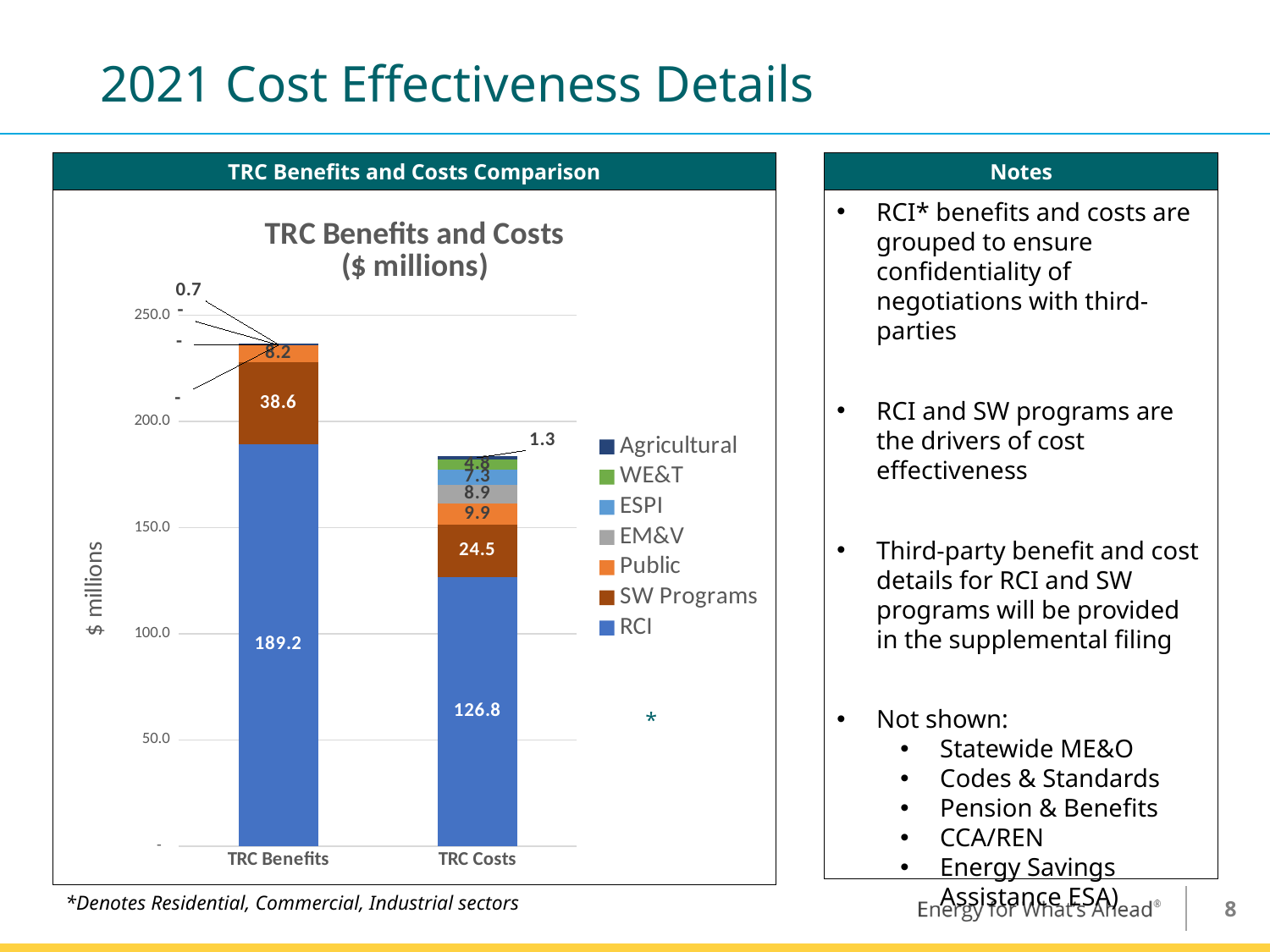
What is the RCI value for TRC Costs? 126.8 How many categories are shown on the x axis? 2 What is the RCI value for TRC Benefits? 189.2 Which bar has the larger Public value, TRC Benefits or TRC Costs? TRC Costs Is the total height of the TRC Benefits bar greater or less than 200.0? greater What is the Public value for TRC Benefits? 8.2 What is the difference between the RCI values for TRC Benefits and TRC Costs? 62.4 How many series does the legend list? 7 What is the Agricultural value for TRC Costs? 1.3 What kind of chart is shown? Stacked bar chart What is the SW Programs value for TRC Costs? 24.5 What is the difference between the SW Programs values for TRC Benefits and TRC Costs? 14.1